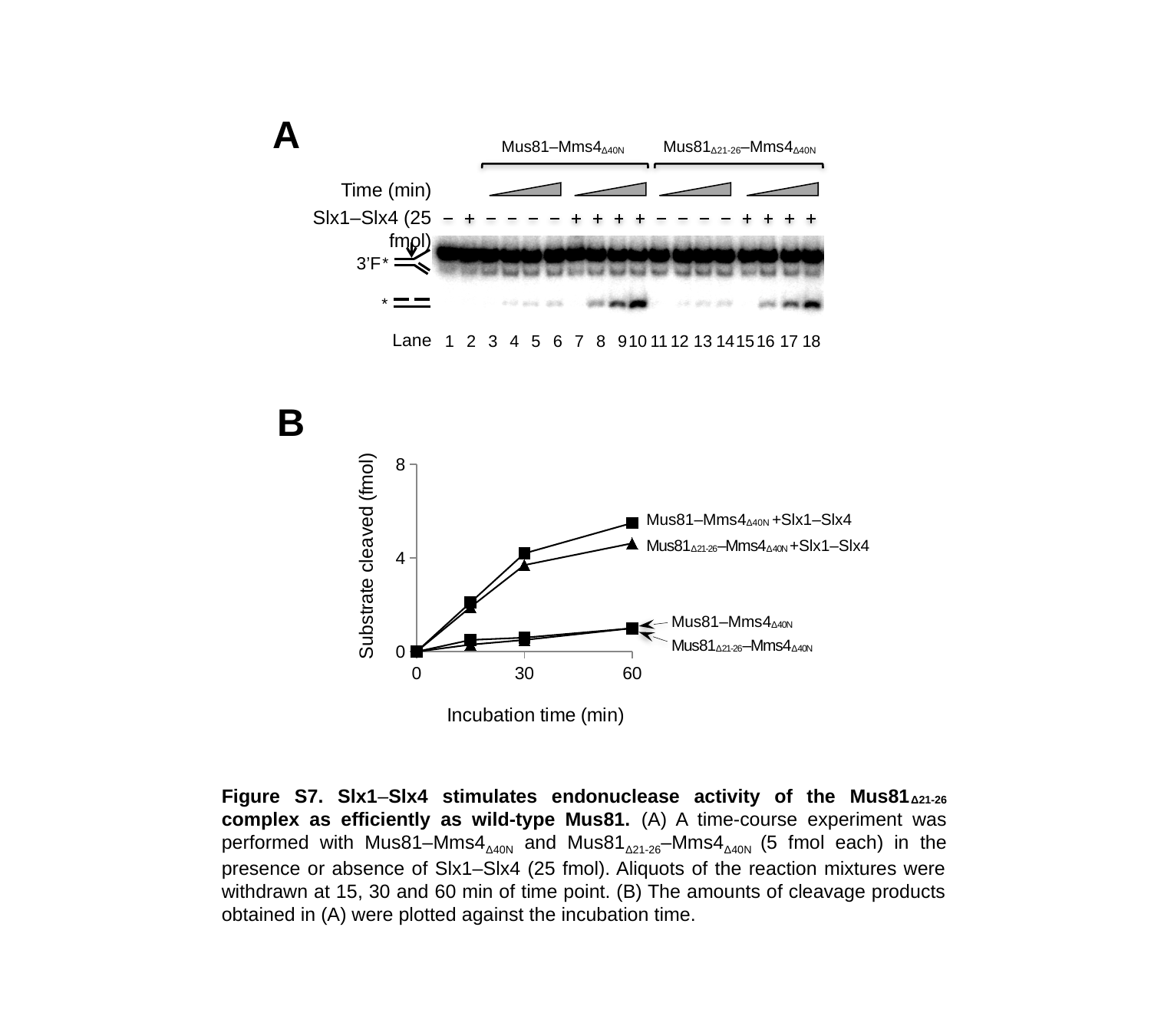
In chart B, what is the label of the x axis? Incubation time (min) In chart B, how many series are plotted? 4 In chart B, what kind of chart is used to plot substrate cleaved against incubation time? line chart In chart B, at 60 min, is the value for Mus81Δ21-26–Mms4Δ40N +Slx1–Slx4 greater or less than 4? greater In chart B, does the value for Mus81–Mms4Δ40N +Slx1–Slx4 rise or fall as incubation time increases? rise In chart B, what is the label of the y axis? Substrate cleaved (fmol) In chart B, at 60 min, is the value for Mus81–Mms4Δ40N (without Slx1–Slx4) greater or less than 4? less In chart B, at 60 min, which is larger: the value for Mus81–Mms4Δ40N +Slx1–Slx4 or the value for Mus81Δ21-26–Mms4Δ40N +Slx1–Slx4? Mus81–Mms4Δ40N +Slx1–Slx4 In chart B, at 30 min, which is larger: the value for Mus81–Mms4Δ40N +Slx1–Slx4 or the value for Mus81–Mms4Δ40N without Slx1–Slx4? Mus81–Mms4Δ40N +Slx1–Slx4 In chart B, how many time points are plotted for each series? 4 In chart B, which series has the highest value at 60 min? Mus81–Mms4Δ40N +Slx1–Slx4 In chart B, at 60 min, is the value for Mus81–Mms4Δ40N +Slx1–Slx4 greater or less than 4? greater